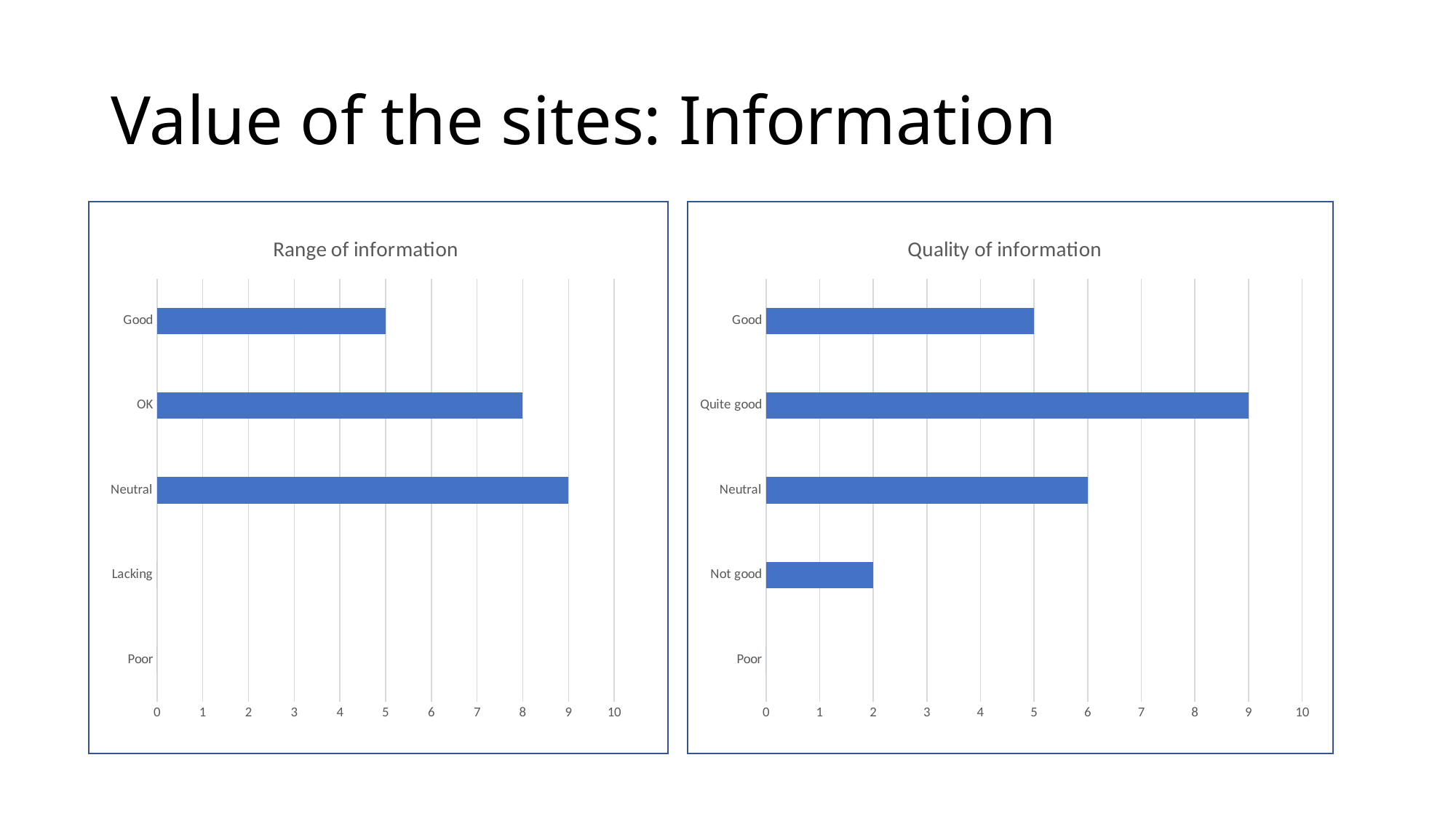
In the 'Quality of information' chart, which is larger, the value for Neutral or the value for Good? Neutral In the 'Range of information' chart, what is the difference between the values for Neutral and Good? 4 In the 'Quality of information' chart, what is the value for Not good? 2 In the 'Quality of information' chart, which category has the highest value? Quite good In the 'Range of information' chart, which category has the highest value? Neutral In the 'Range of information' chart, how many categories are listed on the vertical axis? 5 In the 'Range of information' chart, what is the value for OK? 8 In the 'Quality of information' chart, what is the value for Quite good? 9 In the 'Range of information' chart, what is the value for Neutral? 9 What is the title of the chart on the left side of the slide? Range of information What kind of chart is the 'Quality of information' chart? Bar chart In the 'Quality of information' chart, what is the difference between the values for Quite good and Neutral? 3